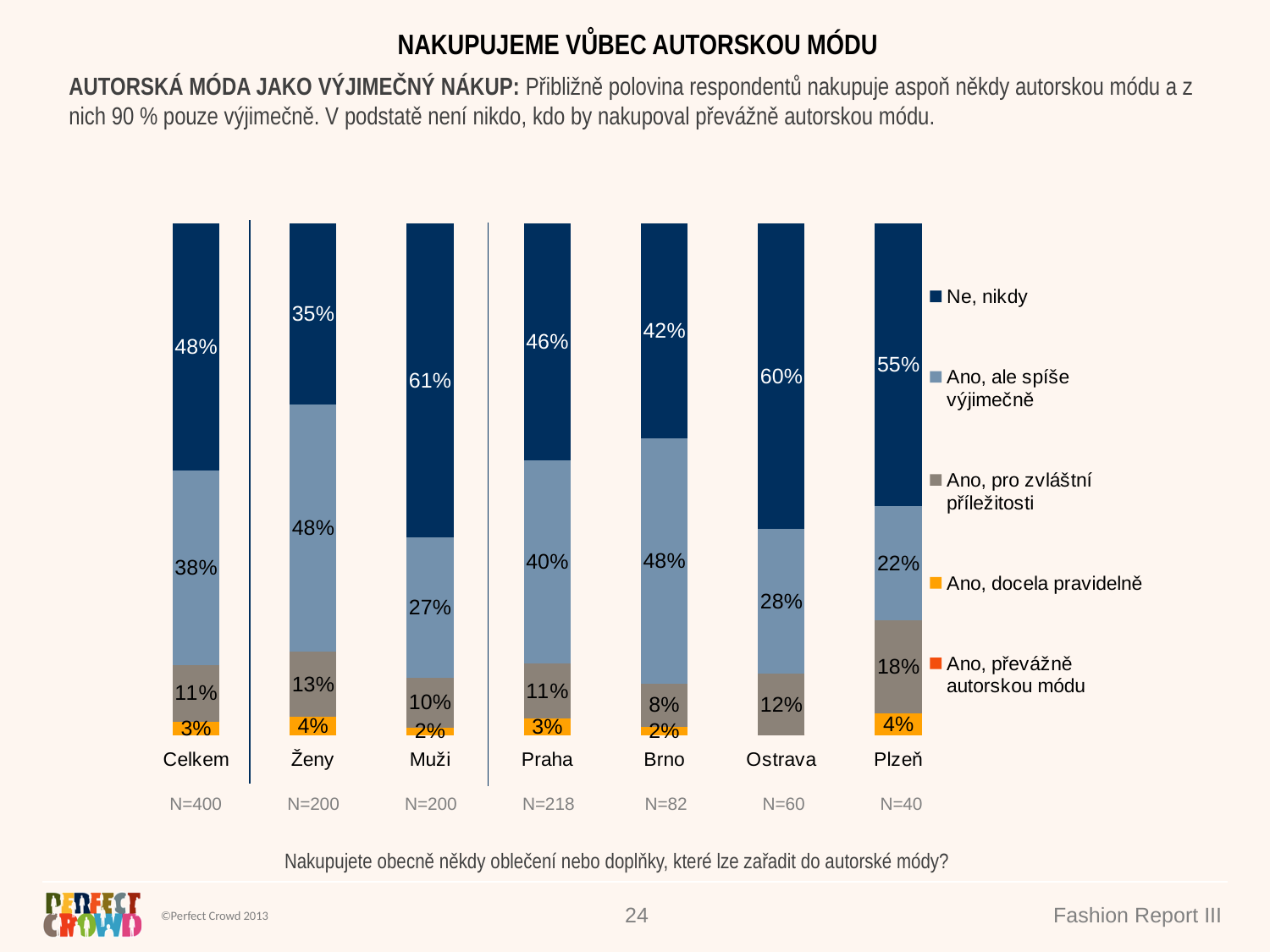
What is the value of 'Ano, ale spíše výjimečně' for Brno? 48% What kind of chart is shown on the slide? Stacked bar chart How many categories (groups) are shown along the x axis of the chart? 7 How many series does the legend list? 5 Which is larger: the 'Ano, pro zvláštní příležitosti' value for Ostrava or for Brno? Ostrava Which category has the lowest value for 'Ano, ale spíše výjimečně'? Plzeň Which category has the highest value for 'Ne, nikdy'? Muži What is the value of 'Ne, nikdy' for Muži? 61% What is the difference between the 'Ne, nikdy' values for Muži and Ženy? 26% What is the value of 'Ano, docela pravidelně' for Ženy? 4% What is the sample size (N) shown for Praha? N=218 What is the value of 'Ano, pro zvláštní příležitosti' for Plzeň? 18%